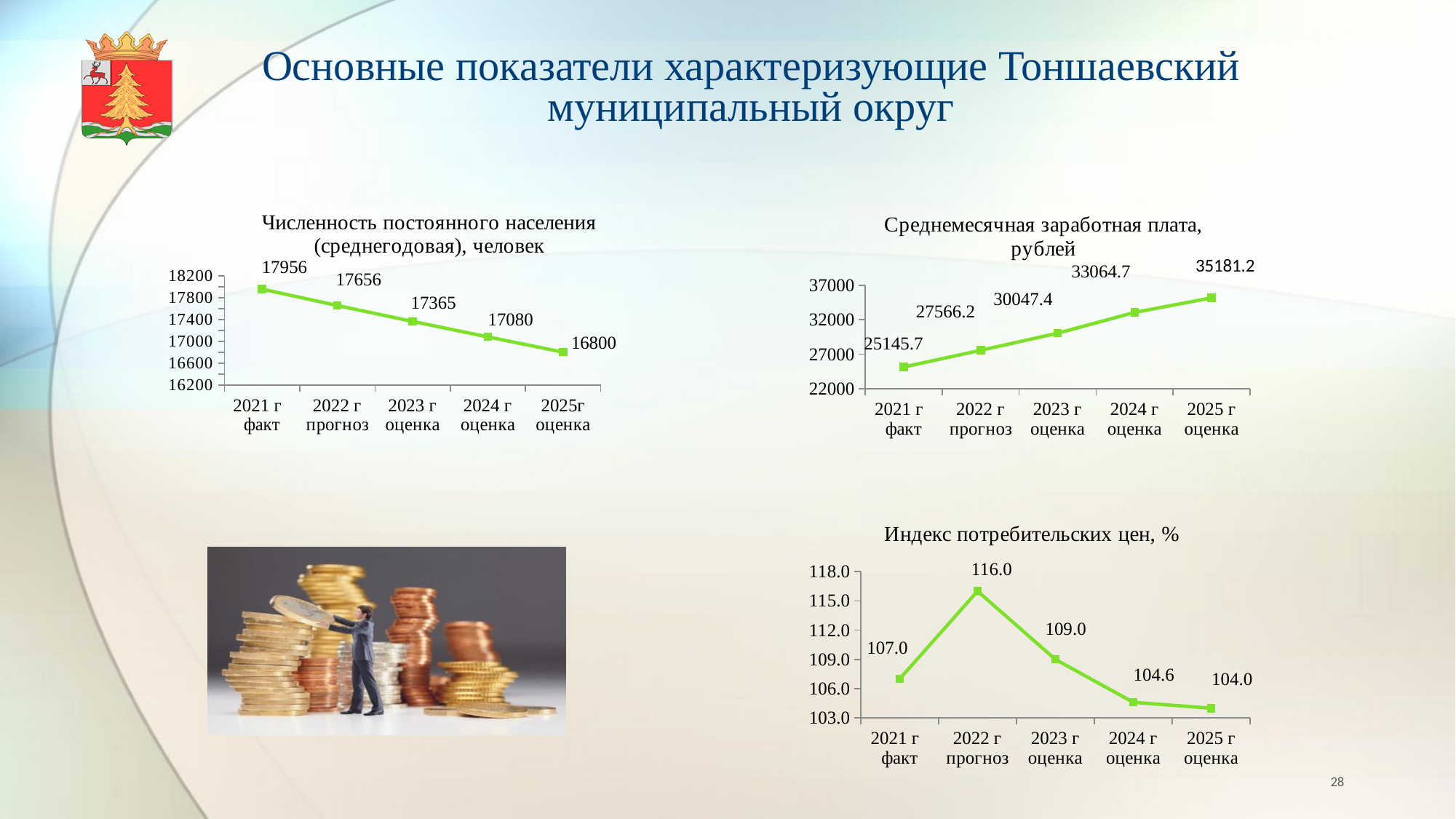
In the chart 'Среднемесячная заработная плата, рублей', what is the value for 2023 г оценка? 30047.4 In the chart 'Среднемесячная заработная плата, рублей', how many data points are plotted? 5 In the chart 'Индекс потребительских цен, %', which year has the lowest value? 2025 г оценка In the chart 'Численность постоянного населения (среднегодовая), человек', what is the difference between the 2021 г факт value and the 2022 г прогноз value? 300 In the chart 'Среднемесячная заработная плата, рублей', which year has the lowest value? 2021 г факт In the chart 'Численность постоянного населения (среднегодовая), человек', what is the value for 2025г оценка? 16800 In the chart 'Численность постоянного населения (среднегодовая), человек', do the values rise or fall from 2021 to 2025? fall In the chart 'Индекс потребительских цен, %', which is larger: the value for 2021 г факт or the value for 2023 г оценка? 2023 г оценка In the chart 'Среднемесячная заработная плата, рублей', which year has the highest value? 2025 г оценка In the chart 'Численность постоянного населения (среднегодовая), человек', what is the value for 2021 г факт? 17956 In the chart 'Индекс потребительских цен, %', what is the value for 2022 г прогноз? 116.0 What type of chart is 'Индекс потребительских цен, %'? line chart